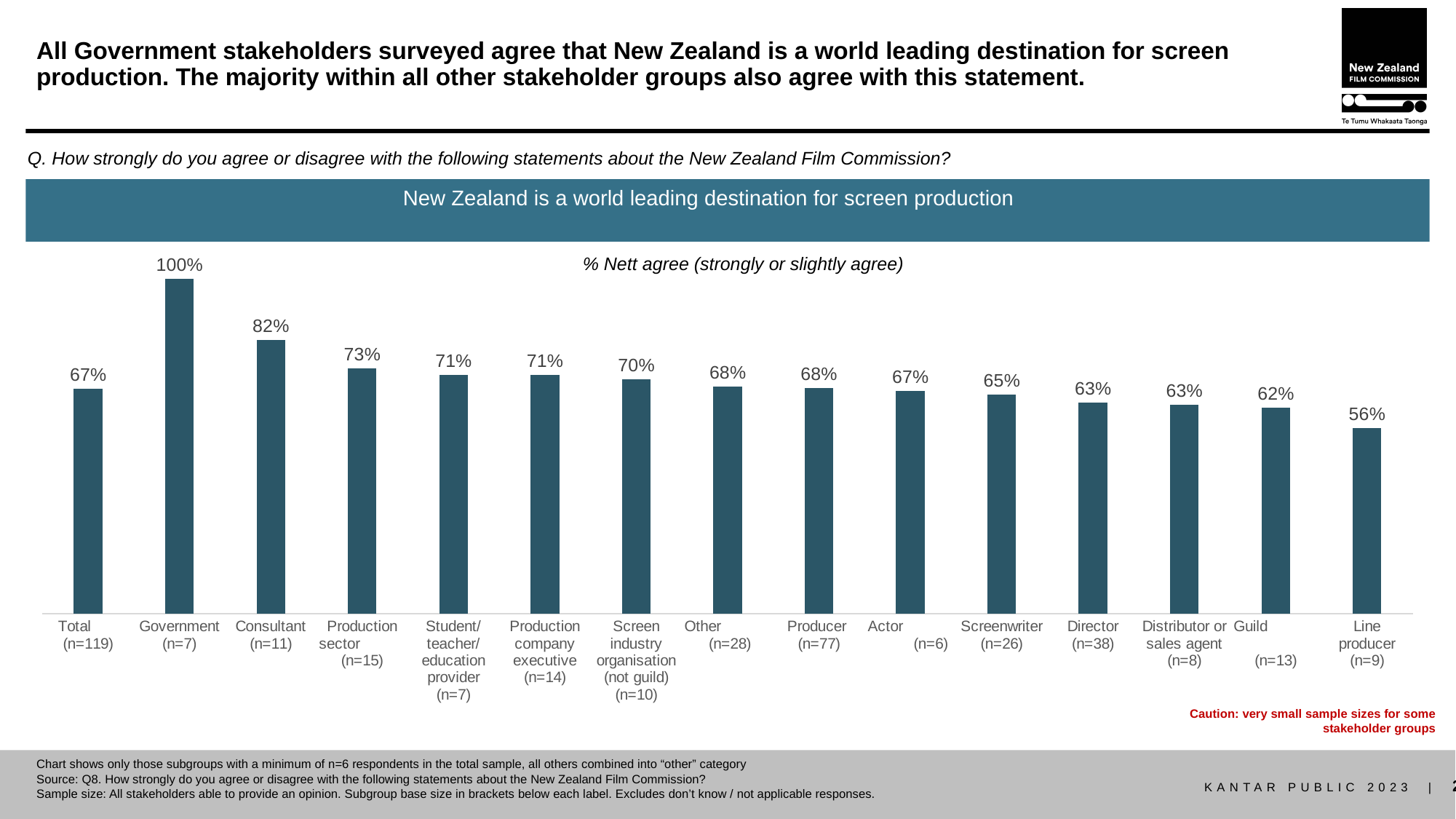
Which stakeholder group has the highest % Nett agree? Government What kind of chart is shown on the slide? Bar chart What is the % Nett agree value for Line producer (n=9)? 56% What is the % Nett agree value for Total (n=119)? 67% What is the title shown in the banner above the chart? New Zealand is a world leading destination for screen production Which has a higher % Nett agree, Production sector or Screenwriter? Production sector What is the % Nett agree value for Government (n=7)? 100% Which stakeholder group has the lowest % Nett agree? Line producer What is the difference in % Nett agree between Consultant and Total? 15 percentage points What is the difference in % Nett agree between Government and Line producer? 44 percentage points What is the % Nett agree value for Consultant (n=11)? 82% How many bars (stakeholder groups including Total) are shown in the chart? 15